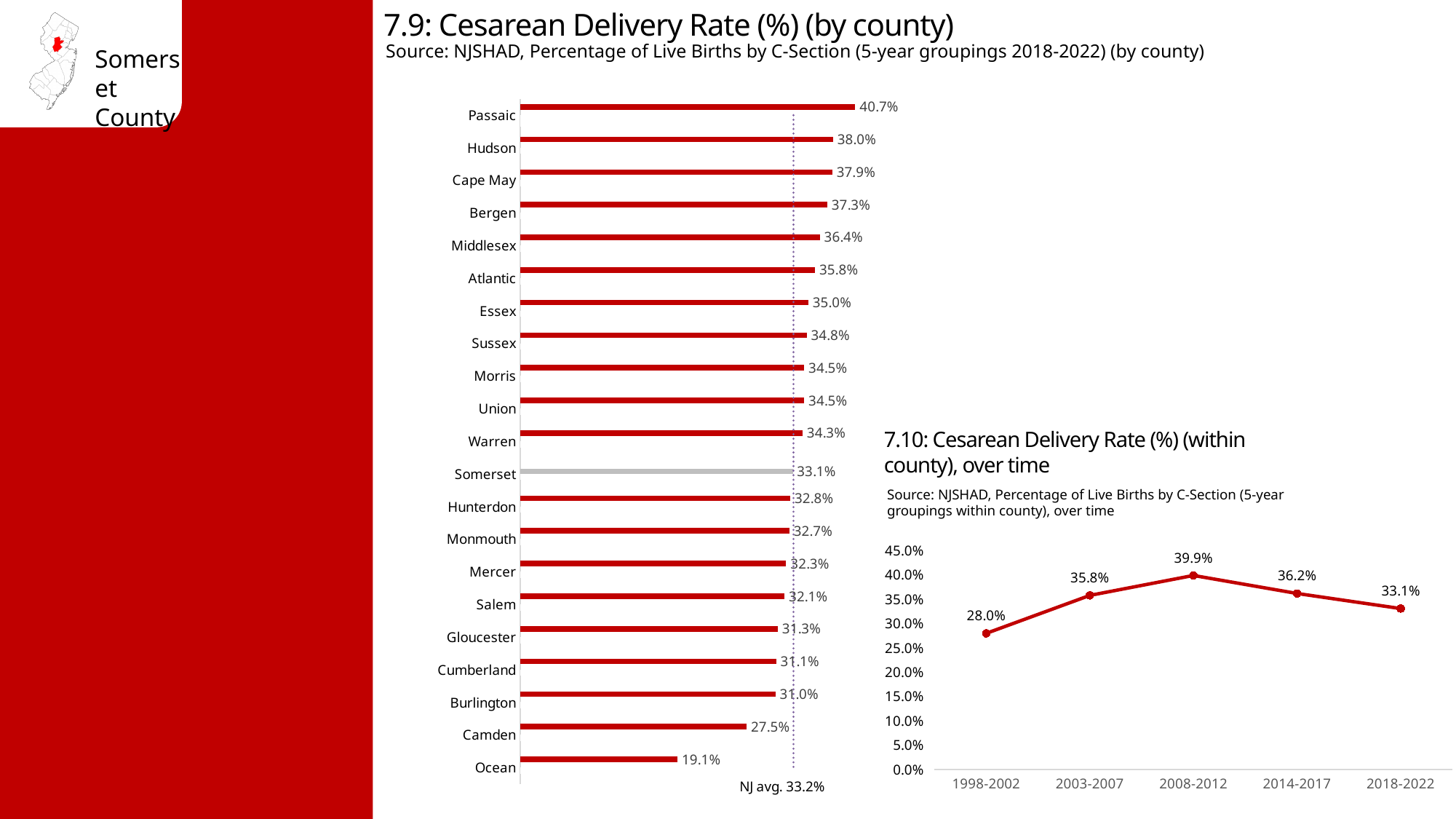
In the 7.9 chart (by county), what is the cesarean delivery rate for Somerset? 33.1% In the 7.9 chart (by county), what is the NJ average shown by the dotted line? 33.2% In the 7.10 chart (within county, over time), how many time periods are plotted? 5 In the 7.10 chart (within county, over time), what is the difference between the 2008-2012 and 2018-2022 rates? 6.8% In the 7.10 chart (within county, over time), what is the cesarean delivery rate for 2008-2012? 39.9% In the 7.9 chart (by county), what is the difference between the rates for Passaic and Ocean? 21.6% What kind of chart is the 7.10 chart (within county, over time)? line chart In the 7.10 chart (within county, over time), which period has the lowest rate? 1998-2002 In the 7.9 chart (by county), which county has the lowest cesarean delivery rate? Ocean In the 7.9 chart (by county), which has a higher cesarean delivery rate, Hudson or Camden? Hudson In the 7.9 chart (by county), how many counties are shown? 21 In the 7.9 chart (by county), which county has the highest cesarean delivery rate? Passaic